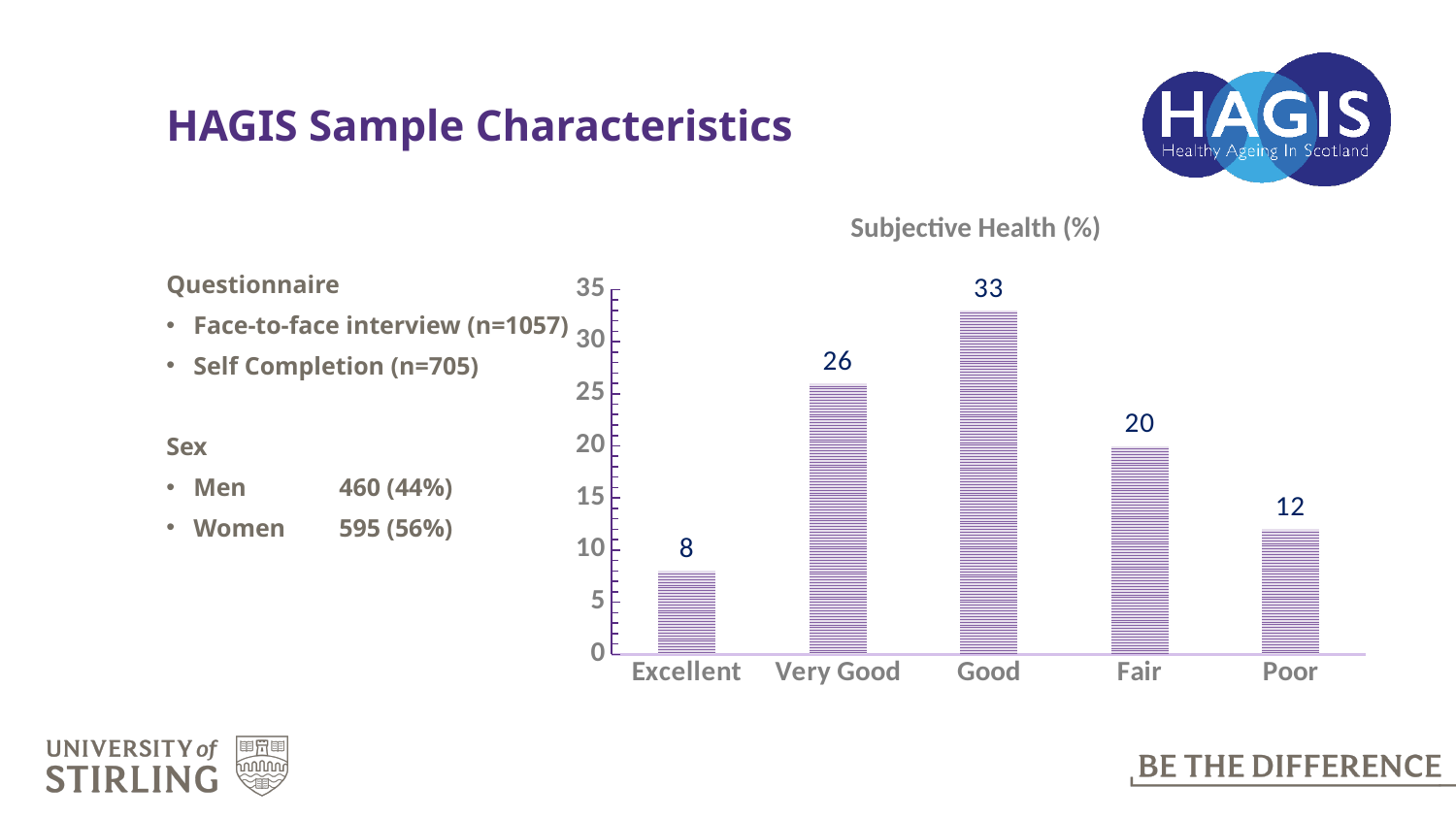
Which category has the lowest value in the Subjective Health (%) chart? Excellent What is the value for Good in the Subjective Health (%) chart? 33 What is the difference between the values for Fair and Poor in the Subjective Health (%) chart? 8 What is the value for Poor in the Subjective Health (%) chart? 12 What kind of chart is the Subjective Health (%) chart? bar chart What is the difference between the values for Good and Very Good in the Subjective Health (%) chart? 7 How many categories are shown on the x axis of the Subjective Health (%) chart? 5 Which is larger in the Subjective Health (%) chart, Very Good or Fair? Very Good What is the value for Excellent in the Subjective Health (%) chart? 8 What is the title of the chart on the slide? Subjective Health (%) Which category has the highest value in the Subjective Health (%) chart? Good Is the value for Very Good greater or less than 25 in the Subjective Health (%) chart? greater